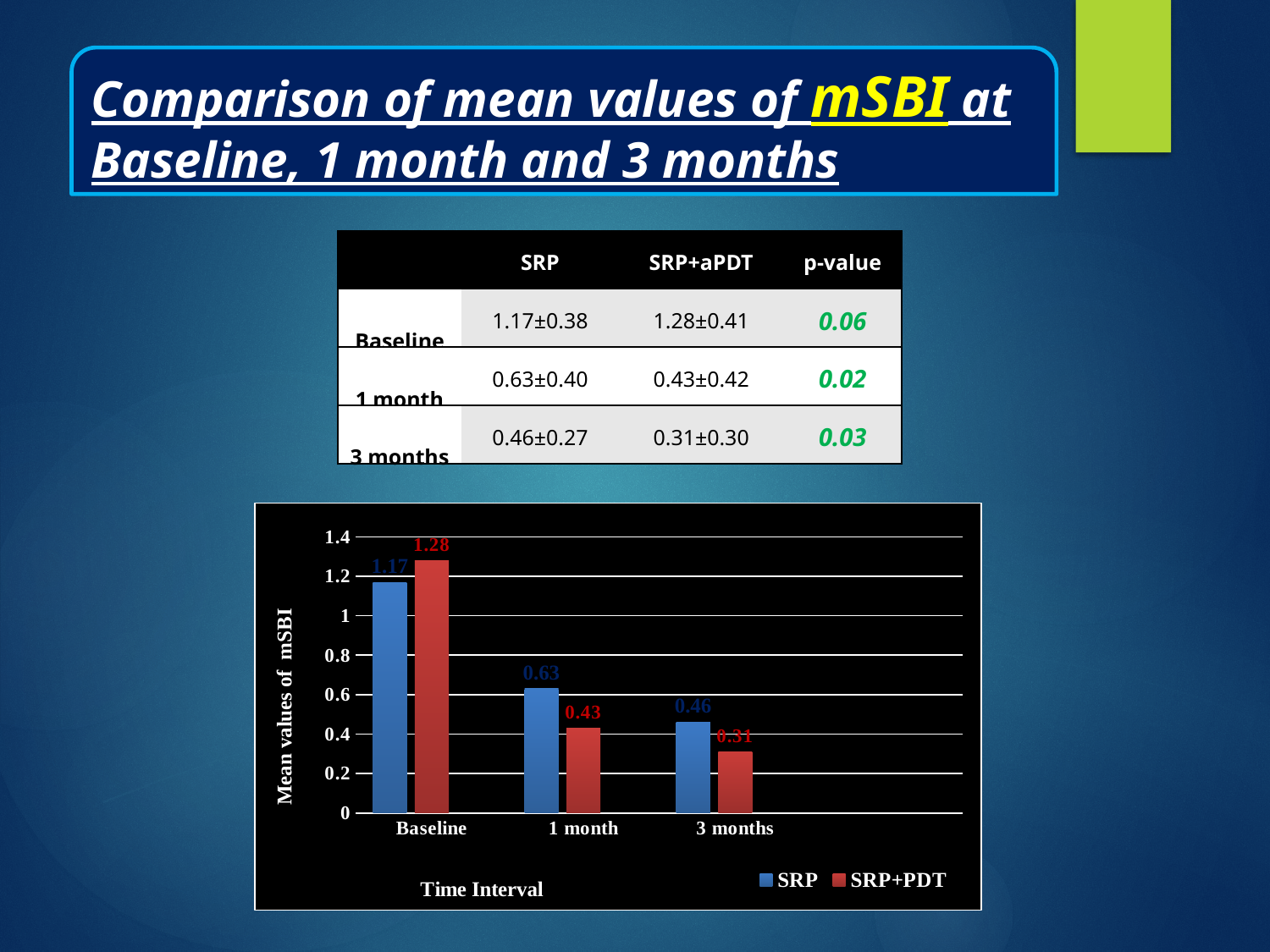
Is the SRP value at 3 months greater or less than 0.4? greater How many time intervals are shown on the x axis? 3 How many series does the legend list? 2 What is the mean mSBI value for SRP+PDT at 3 months? 0.31 Which is larger at Baseline, the SRP value or the SRP+PDT value? SRP+PDT What kind of chart is shown? bar chart What is the difference between the SRP and SRP+PDT values at 1 month? 0.20 Do the SRP values rise or fall from Baseline to 3 months? fall At which time interval is the SRP+PDT value highest? Baseline What is the mean mSBI value for SRP+PDT at 1 month? 0.43 At which time interval is the SRP value lowest? 3 months What is the mean mSBI value for SRP at Baseline? 1.17